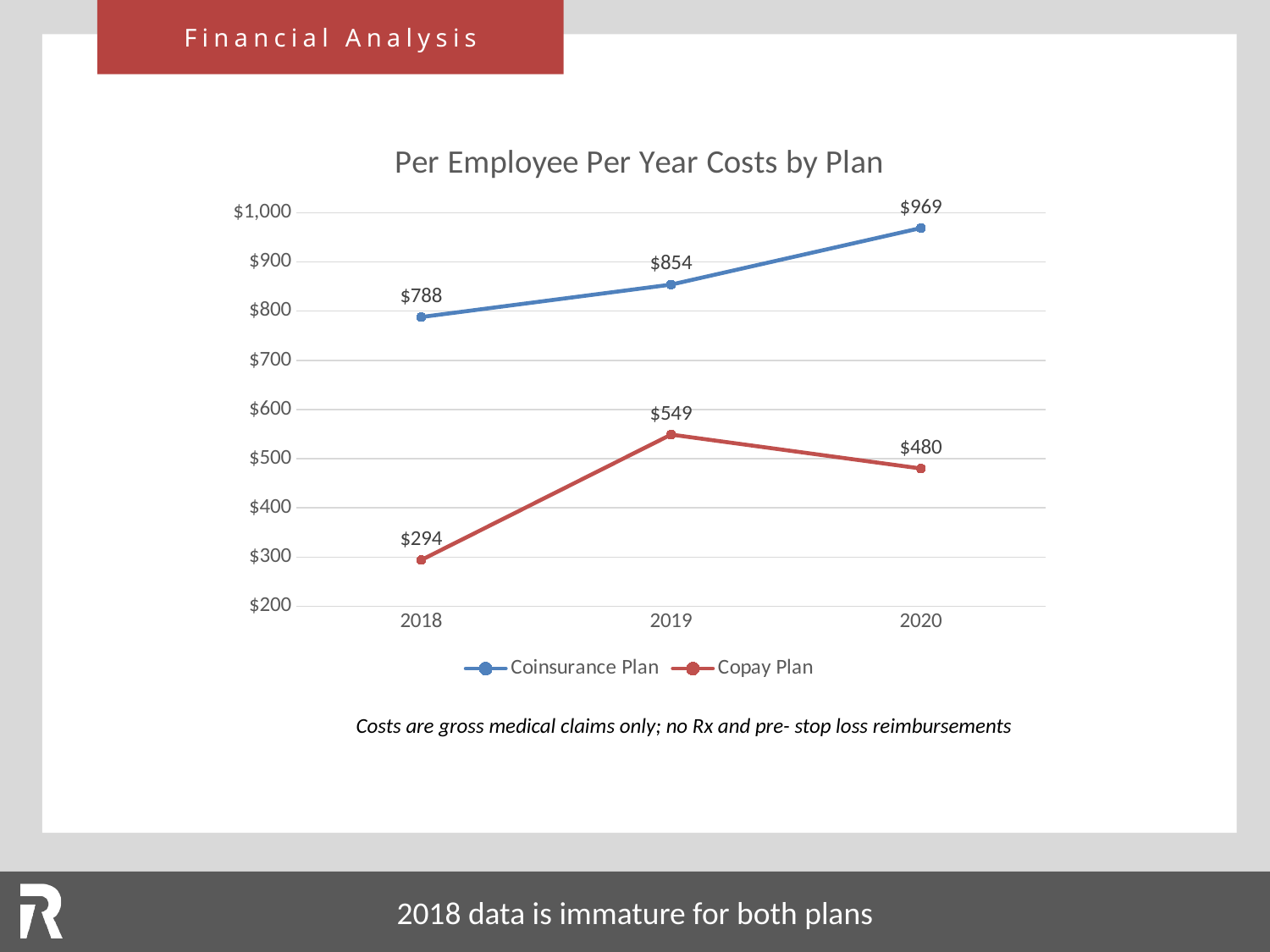
What is the Copay Plan per employee per year cost in 2018? $294 What is the Copay Plan value for 2020? $480 In which year is the Coinsurance Plan cost highest? 2020 Does the Coinsurance Plan cost rise or fall from 2018 to 2020? Rise How many years are shown on the x axis? 3 How many series does the legend list? 2 Which plan has the higher cost in 2019, Coinsurance Plan or Copay Plan? Coinsurance Plan What is the difference between the Coinsurance Plan and Copay Plan costs in 2020? $489 What is the Coinsurance Plan per employee per year cost in 2019? $854 By how much did the Copay Plan cost increase from 2018 to 2019? $255 In which year is the Copay Plan cost lowest? 2018 What kind of chart is shown on the slide? Line chart